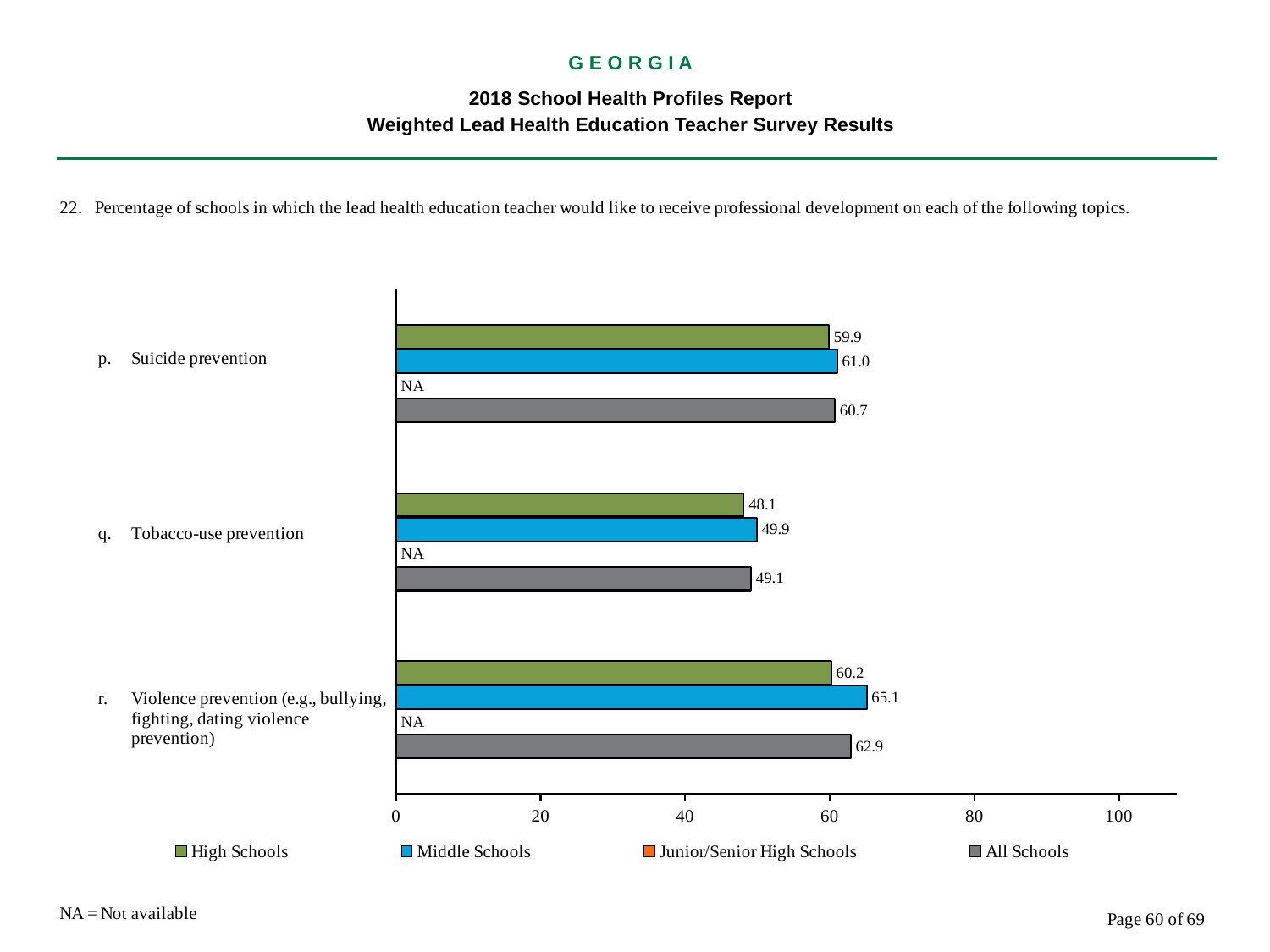
How many topics are shown on the chart? 3 Is the All Schools value for Suicide prevention greater or less than 60? greater Which topic has the highest value for Middle Schools? Violence prevention (e.g., bullying, fighting, dating violence prevention) What kind of chart is shown on the slide? bar chart What is the difference between the Middle Schools and High Schools values for Violence prevention (e.g., bullying, fighting, dating violence prevention)? 4.9 What is the value for Middle Schools for Violence prevention (e.g., bullying, fighting, dating violence prevention)? 65.1 What is the value for High Schools for Suicide prevention? 59.9 What is the value for All Schools for Tobacco-use prevention? 49.1 Which topic has the lowest value for High Schools? Tobacco-use prevention How many series does the legend list? 4 Which is larger for Tobacco-use prevention: the Middle Schools value or the All Schools value? Middle Schools What is the value for Junior/Senior High Schools for Tobacco-use prevention? NA